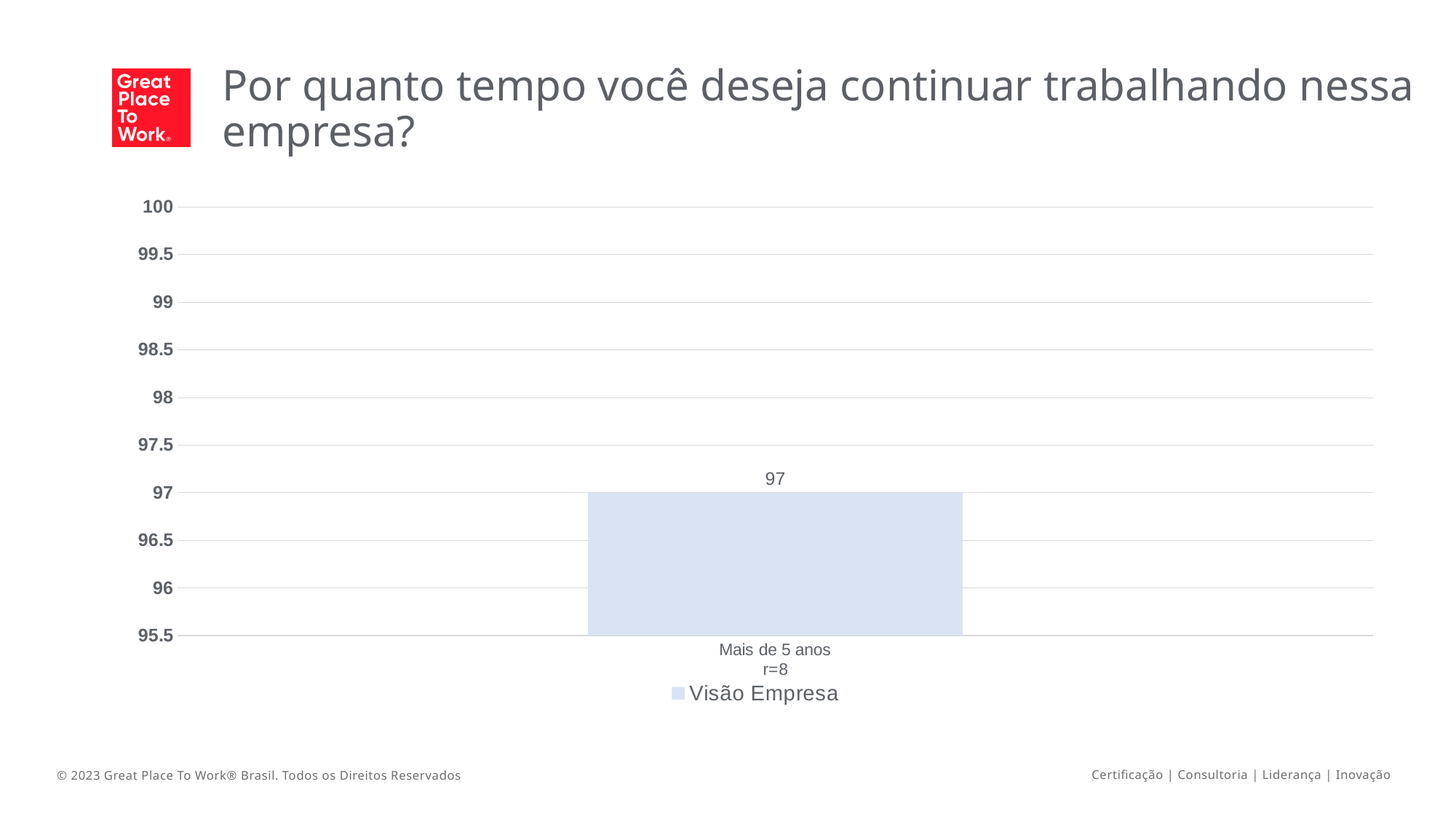
How many series does the legend list? 1 What kind of chart is shown on the slide? bar chart Is the value for "Mais de 5 anos" greater or less than 96? greater Is the value for "Mais de 5 anos" greater or less than 98? less What is the value for "Mais de 5 anos"? 97 What is the highest value shown on the vertical axis? 100 What is the number of respondents (r) shown under the category label? r=8 What is the lowest value shown on the vertical axis? 95.5 What is the name of the series shown in the legend? Visão Empresa How many categories are plotted on the chart? 1